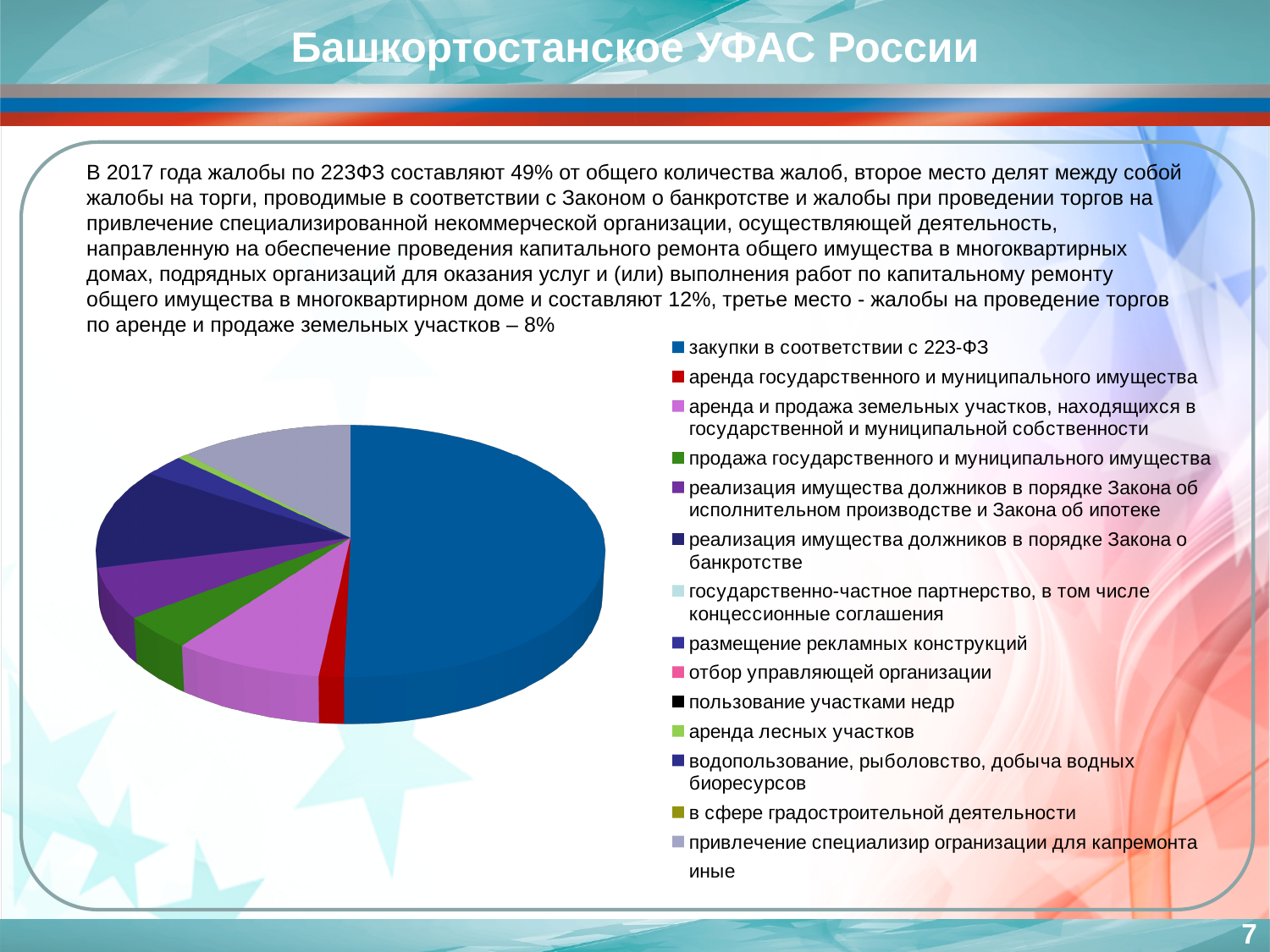
Which slice is larger: "закупки в соответствии с 223-ФЗ" or "продажа государственного и муниципального имущества"? закупки в соответствии с 223-ФЗ What colour is the slice for "закупки в соответствии с 223-ФЗ" in the pie chart? blue Which slice is larger: "аренда и продажа земельных участков, находящихся в государственной и муниципальной собственности" or "аренда государственного и муниципального имущества"? аренда и продажа земельных участков, находящихся в государственной и муниципальной собственности How many entries does the legend of the pie chart list? 15 What kind of chart is shown on the slide? pie chart Which legend entry is shown in red in the pie chart? аренда государственного и муниципального имущества Which slice is larger: "закупки в соответствии с 223-ФЗ" or "аренда государственного и муниципального имущества"? закупки в соответствии с 223-ФЗ Which category has the largest slice in the pie chart? закупки в соответствии с 223-ФЗ